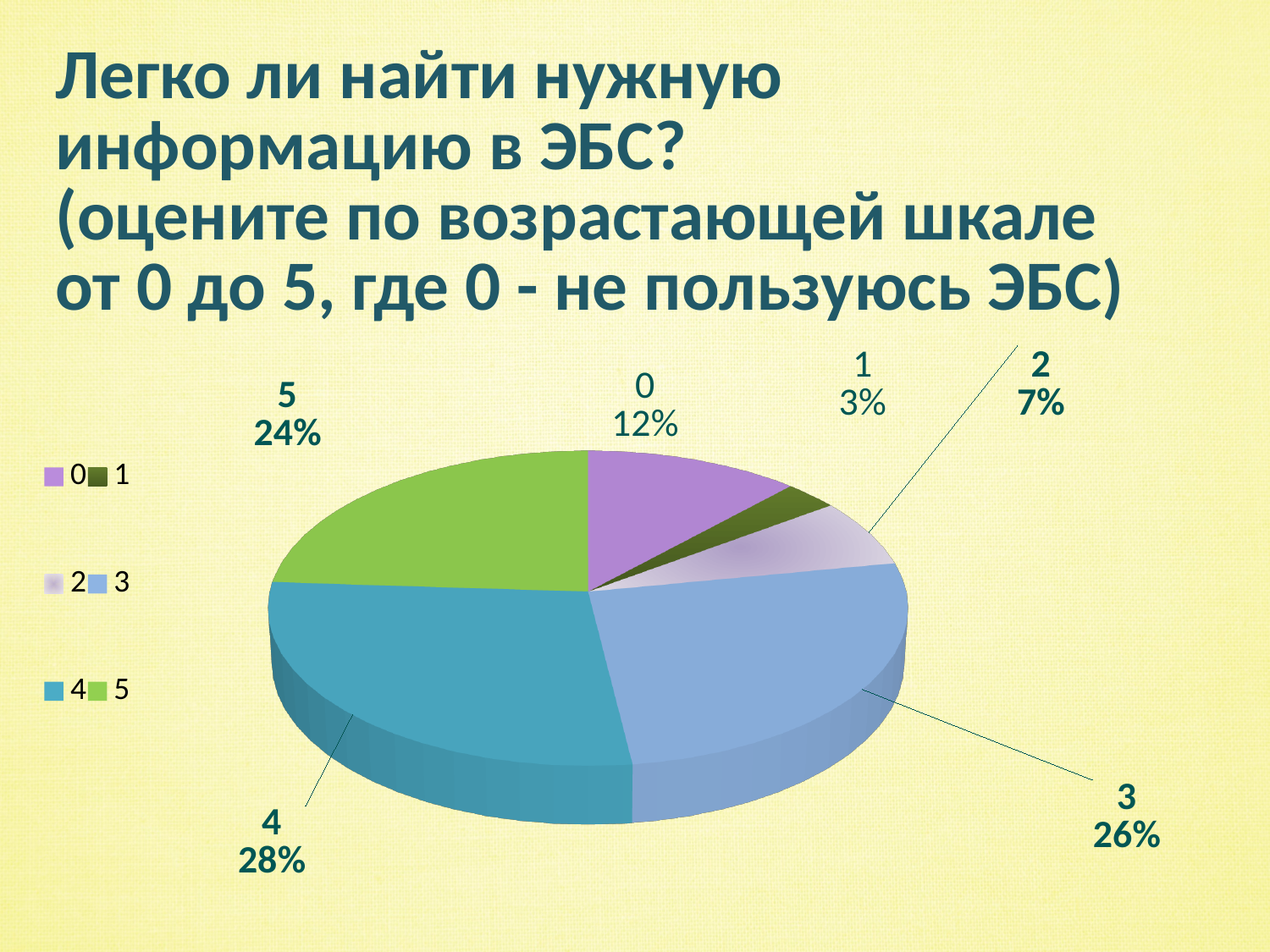
What share of the pie does the rating 1 slice have? 3% How many slices does the pie chart have? 6 What kind of chart is shown on the slide? pie chart Which rating has the largest slice of the pie? 4 What share of the pie does the rating 5 slice have? 24% What is the difference in percentage points between the rating 3 slice and the rating 2 slice? 19% Which rating has the smallest slice of the pie? 1 How many entries does the legend list? 6 What share of the pie does the rating 4 slice have? 28% What colour is the rating 5 slice in the pie chart? green Which slice is larger, rating 5 or rating 0? 5